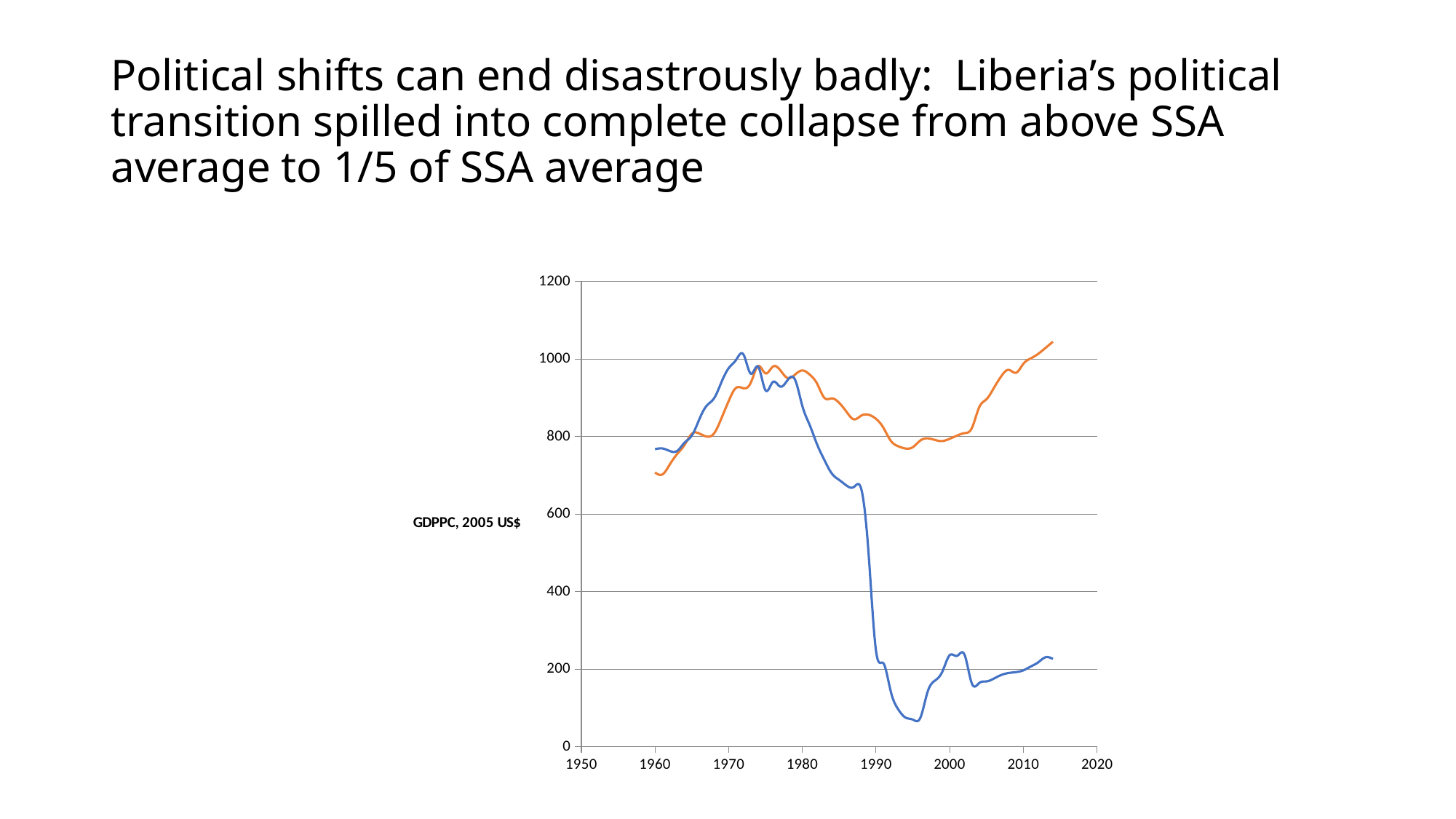
How many lines are plotted on the chart? 2 Does the orange line rise or fall between 2000 and 2014? rise Does the blue line rise or fall between 1980 and 1995? fall Is the value of the blue line around 1995 greater or less than 200? less Is the value of the orange line at its start around 1960 greater or less than 800? less Is the value of the orange line around 2010 greater or less than 800? greater What is the highest value shown on the vertical axis? 1200 Around 2010, which line is higher, the blue line or the orange line? orange line What is the label on the vertical axis of the chart? GDPPC, 2005 US$ What kind of chart is shown on the slide? line chart